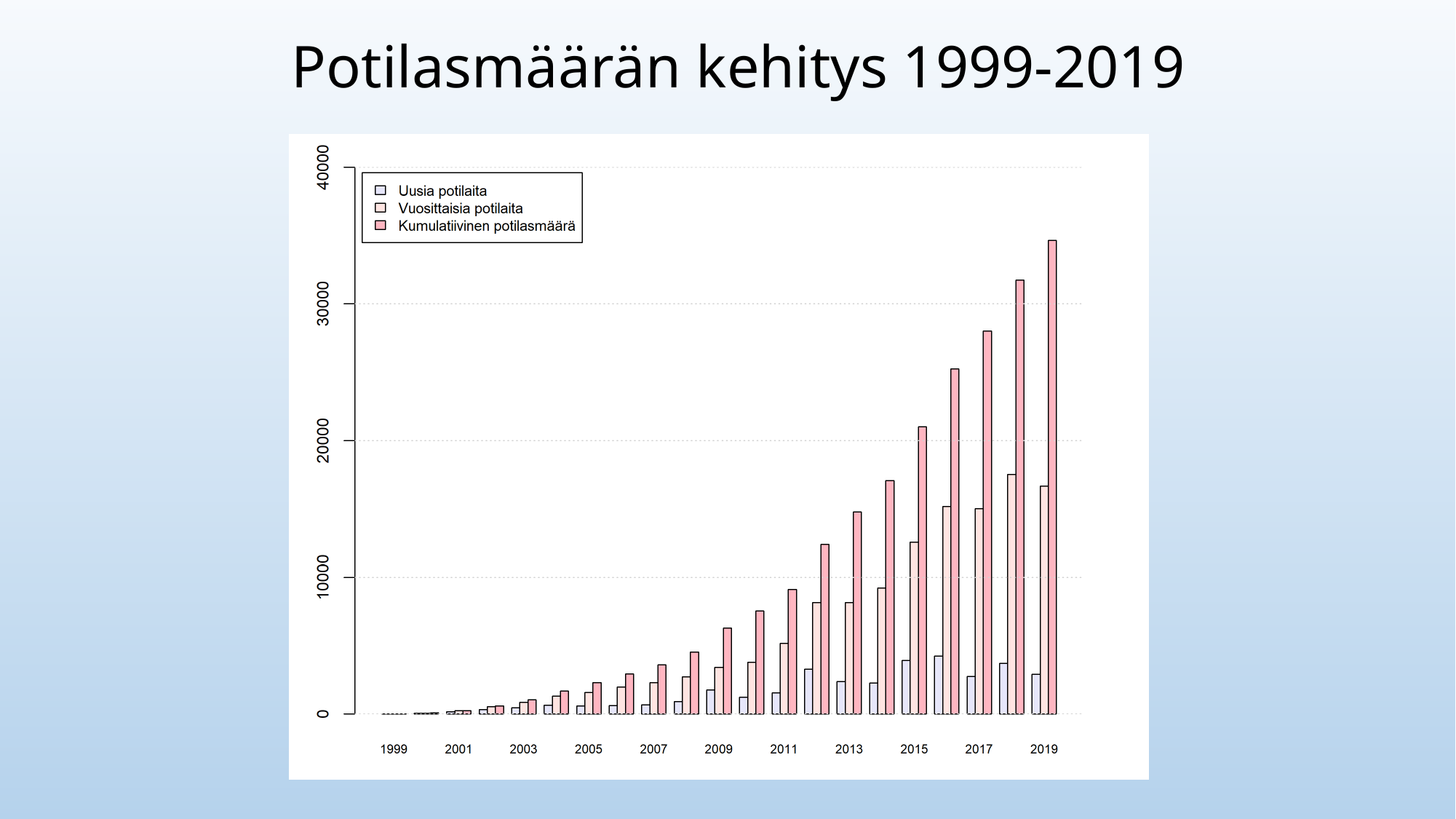
Is the Kumulatiivinen potilasmäärä value for 2019 greater or less than 30000? greater In which year is the Kumulatiivinen potilasmäärä bar highest? 2019 Does the Kumulatiivinen potilasmäärä series rise or fall from 1999 to 2019? rise How many years are plotted along the x axis? 21 Is the Kumulatiivinen potilasmäärä value for 2017 greater or less than 30000? less What kind of chart is shown on the slide? bar chart Is the Vuosittaisia potilaita value for 2019 greater or less than 10000? greater Which series is listed last in the legend? Kumulatiivinen potilasmäärä How many series does the legend list? 3 In 2019, which is larger: the Kumulatiivinen potilasmäärä bar or the Vuosittaisia potilaita bar? Kumulatiivinen potilasmäärä What is the title of the slide's chart? Potilasmäärän kehitys 1999-2019